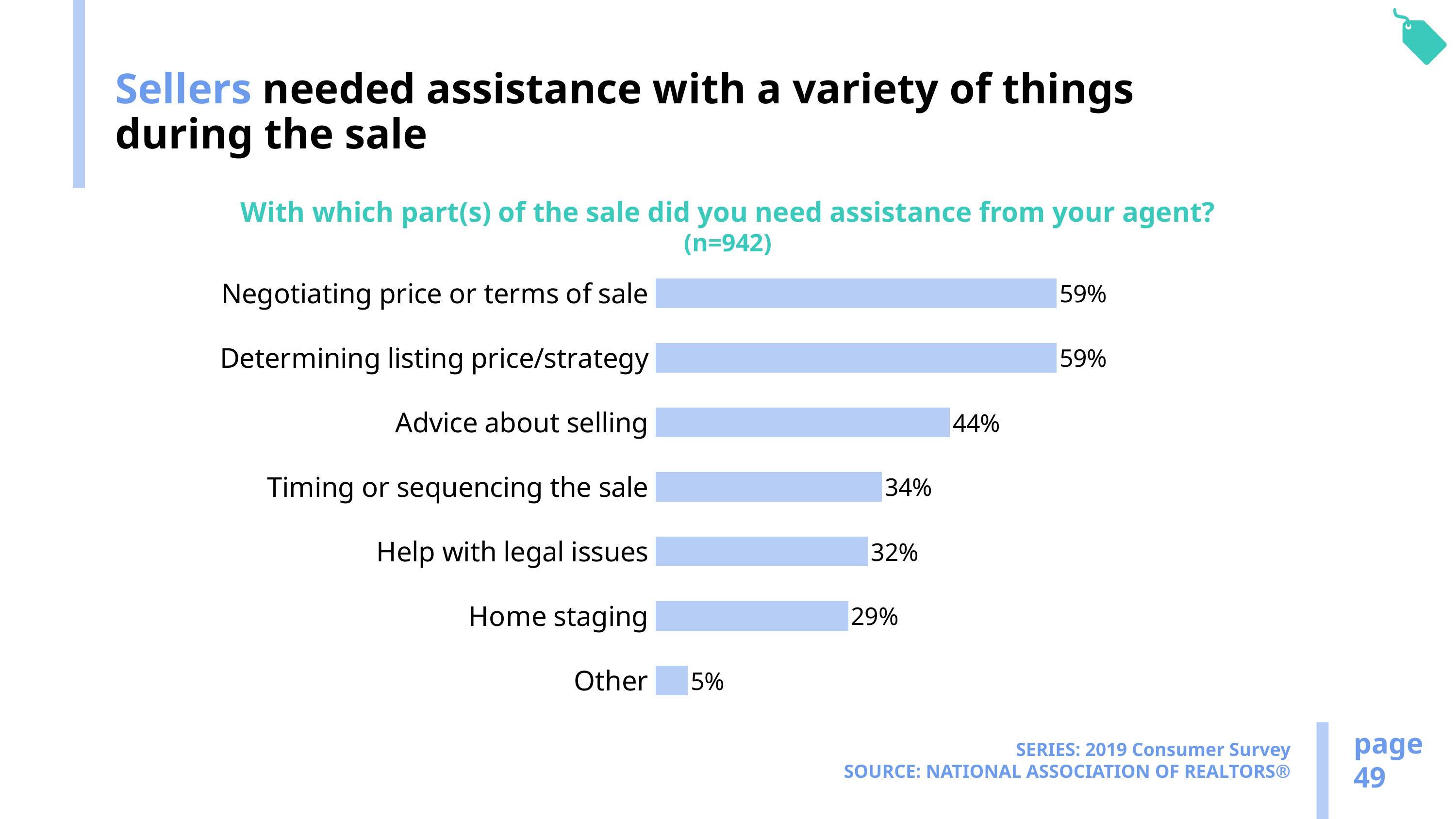
Which category has the lowest value? Other What kind of chart is shown on the slide? Bar chart What is the value shown for Advice about selling? 44% What is the sample size (n) stated in the chart title? 942 What percentage of sellers needed help with legal issues? 32% What is the difference between Negotiating price or terms of sale and Other? 54% What percentage of sellers needed assistance with negotiating price or terms of sale? 59% What is the difference between Advice about selling and Timing or sequencing the sale? 10% What is the value for Timing or sequencing the sale? 34% How many categories are shown in the chart? 7 What is the value for Home staging? 29% Which is larger: Help with legal issues or Home staging? Help with legal issues